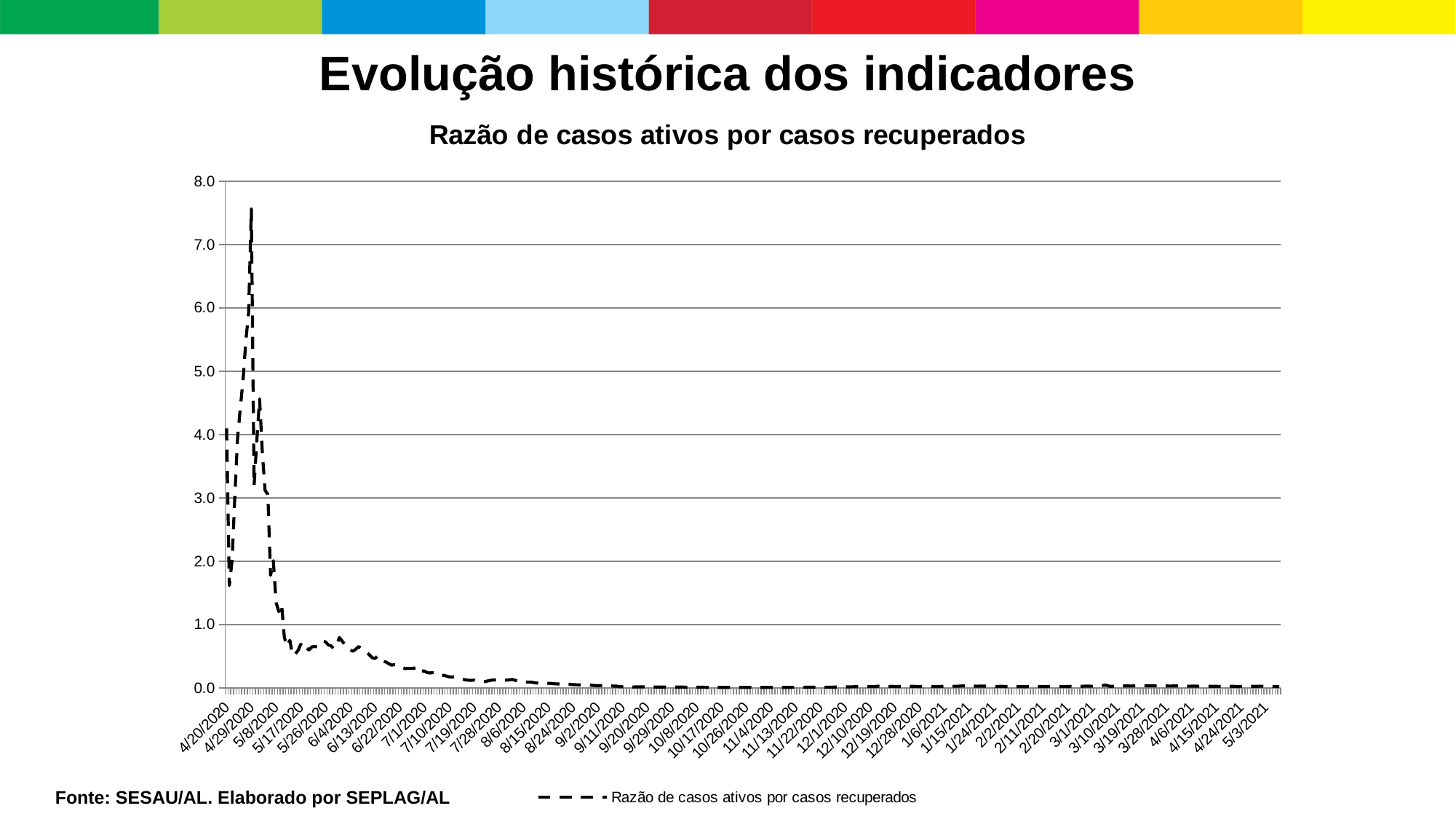
Is the value for 9/11/2020 greater or less than 1.0? less Is the peak value of the line greater or less than 7.0? greater Is the value for 5/3/2021 greater or less than 1.0? less How many series does the legend list? 1 Near which labelled date does the line reach its highest value? 4/29/2020 What kind of chart is shown on the slide? Line chart What is the title of the chart? Razão de casos ativos por casos recuperados What is the highest value shown on the y axis? 8.0 After its peak, does the line generally rise or fall along the x axis? Fall How many date labels are shown on the x axis? 43 What is the name of the series shown in the legend? Razão de casos ativos por casos recuperados